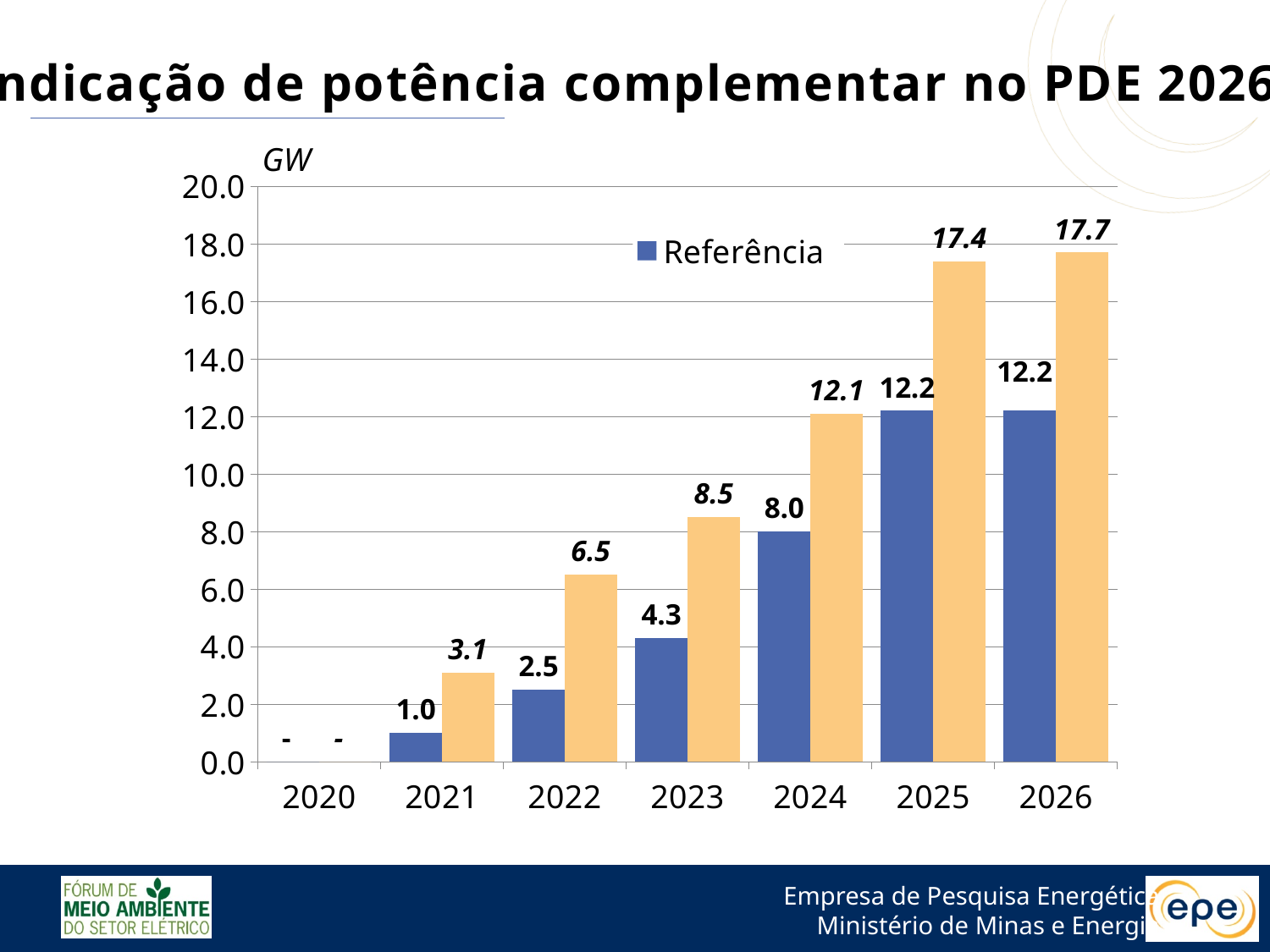
What is the Referência value for 2023? 4.3 What unit is indicated above the y axis? GW What is the Referência value for 2024? 8.0 What value is labelled on the orange bar for 2022? 6.5 Which year has the highest orange bar? 2026 What value is labelled on the orange bar for 2026? 17.7 Which year has the lowest non-zero Referência value? 2021 What kind of chart is shown on the slide? bar chart Which is larger in 2022, the Referência bar or the orange bar? the orange bar What is the difference between the orange bar and the Referência bar in 2025? 5.2 How many years are shown on the x axis? 7 How many series does the legend list? 1